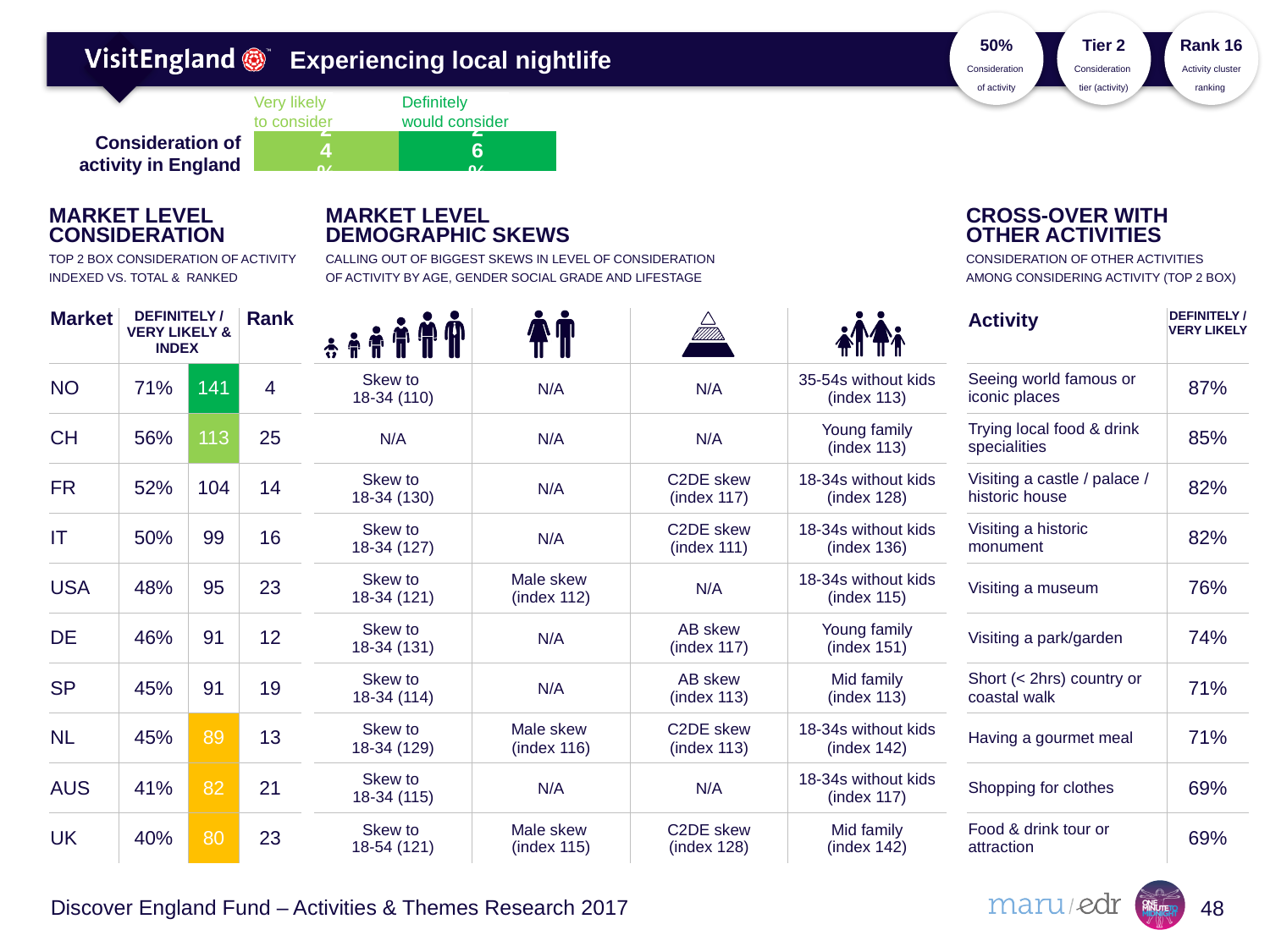
In the 'Consideration of activity in England' chart, what is the difference between 'Definitely would consider' and 'Very likely to consider'? 2% What is the title of the bar chart at the top of the slide? Consideration of activity in England In the 'Consideration of activity in England' chart, which segment is larger: 'Very likely to consider' or 'Definitely would consider'? Definitely would consider In the 'Consideration of activity in England' chart, what is the value for 'Definitely would consider'? 26% In the 'Consideration of activity in England' chart, which segment has the highest value? Definitely would consider How many segments does the 'Consideration of activity in England' stacked bar have? 2 In the 'Consideration of activity in England' chart, what is the value for 'Very likely to consider'? 24% What kind of chart is the 'Consideration of activity in England' chart? bar chart In the 'Consideration of activity in England' chart, which segment has the lowest value? Very likely to consider In the 'Consideration of activity in England' chart, what is the total of the two segments of the stacked bar? 50% In the 'Consideration of activity in England' chart, which segment is shown in the darker green? Definitely would consider